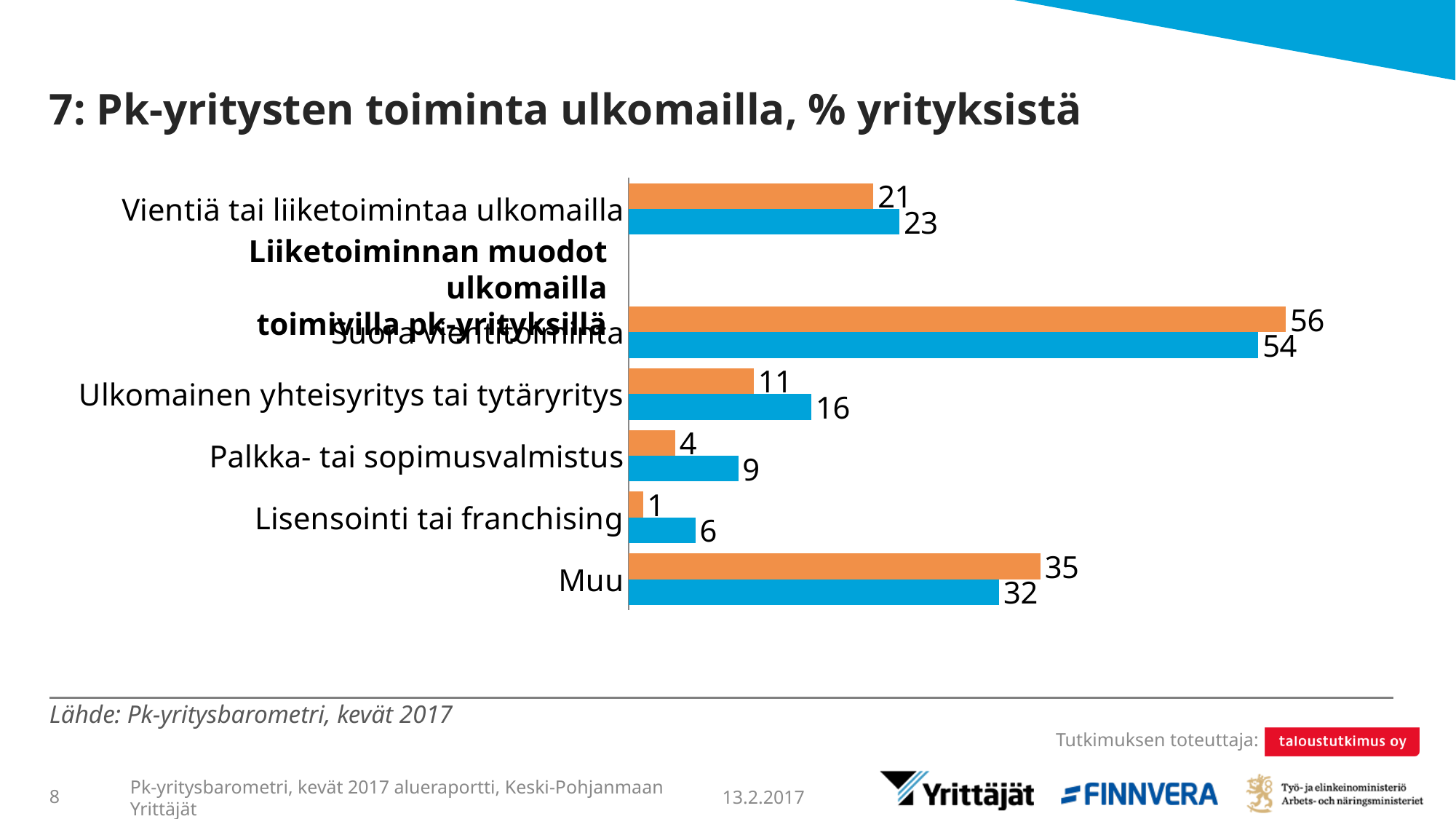
How many categories are shown on the chart? 6 What is the value of the orange bar for Suora vientitoiminta? 56 For Vientiä tai liiketoimintaa ulkomailla, which bar is larger, the orange or the blue? blue What type of chart is shown on the slide? bar chart Which category has the highest orange bar value? Suora vientitoiminta What is the value of the blue bar for Ulkomainen yhteisyritys tai tytäryritys? 16 What is the difference between the blue and orange bar values for Palkka- tai sopimusvalmistus? 5 What is the value of the orange bar for Muu? 35 What is the difference between the orange and blue bar values for Muu? 3 What is the value of the blue bar for Lisensointi tai franchising? 6 What is the title of the slide? 7: Pk-yritysten toiminta ulkomailla, % yrityksistä Which category has the lowest blue bar value? Lisensointi tai franchising